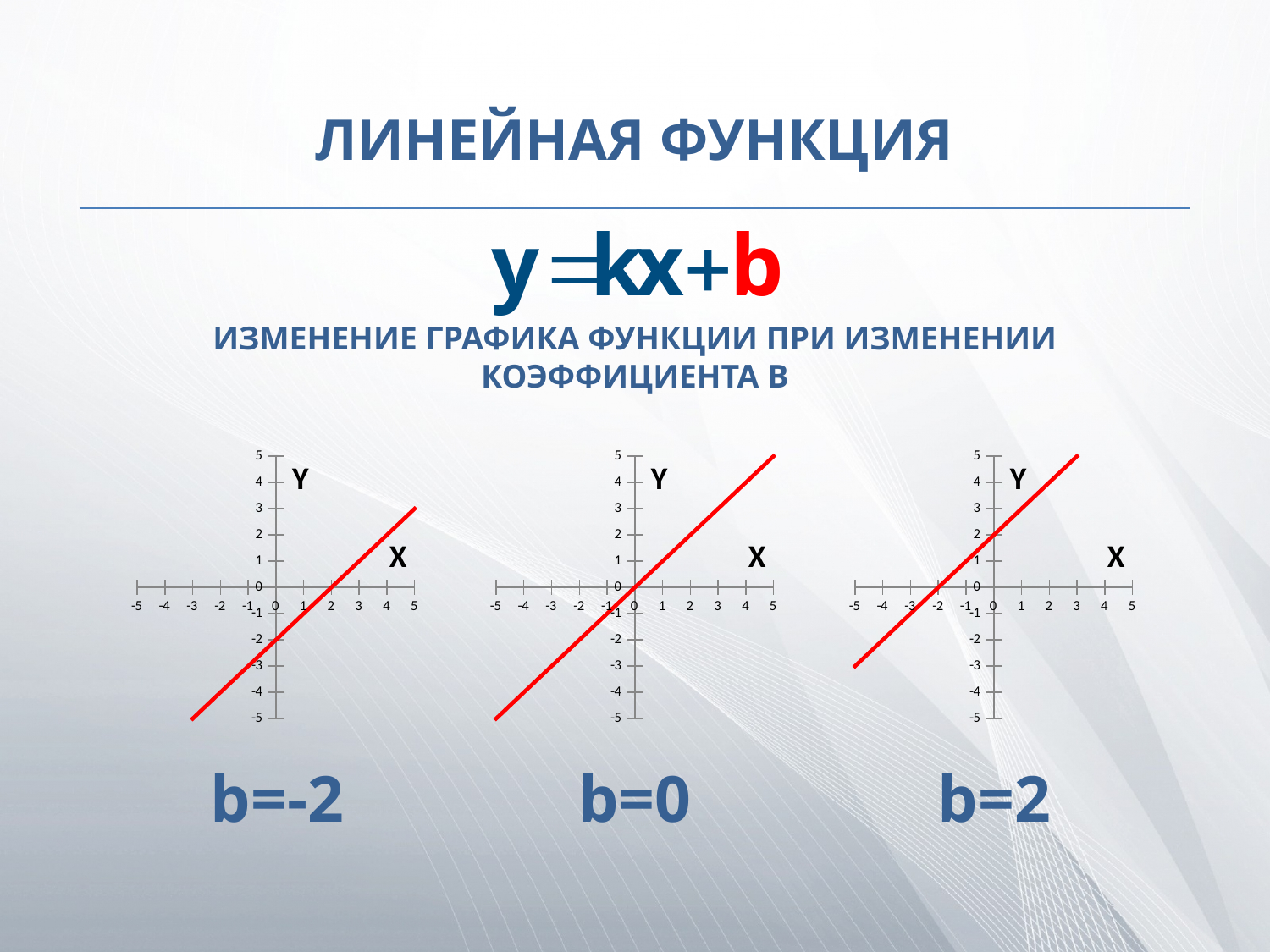
In the left chart labelled b=-2, at what x value does the red line cross the X axis? 2 How many charts are shown on the slide? 3 In the middle chart labelled b=0, does the red line rise or fall as x increases? rise What colour is the plotted line in each of the three charts? red What kind of chart is the left chart labelled b=-2? line chart In the middle chart labelled b=0, at what point does the red line cross the Y axis? 0 What is the maximum value shown on the X axis of the middle chart labelled b=0? 5 In the right chart labelled b=2, at what x value does the red line cross the X axis? -2 Which chart has the lowest y-intercept: the one labelled b=-2, b=0 or b=2? b=-2 In the left chart labelled b=-2, at what y value does the red line cross the Y axis? -2 Which chart has the highest y-intercept: the one labelled b=-2, b=0 or b=2? b=2 In the right chart labelled b=2, at what y value does the red line cross the Y axis? 2